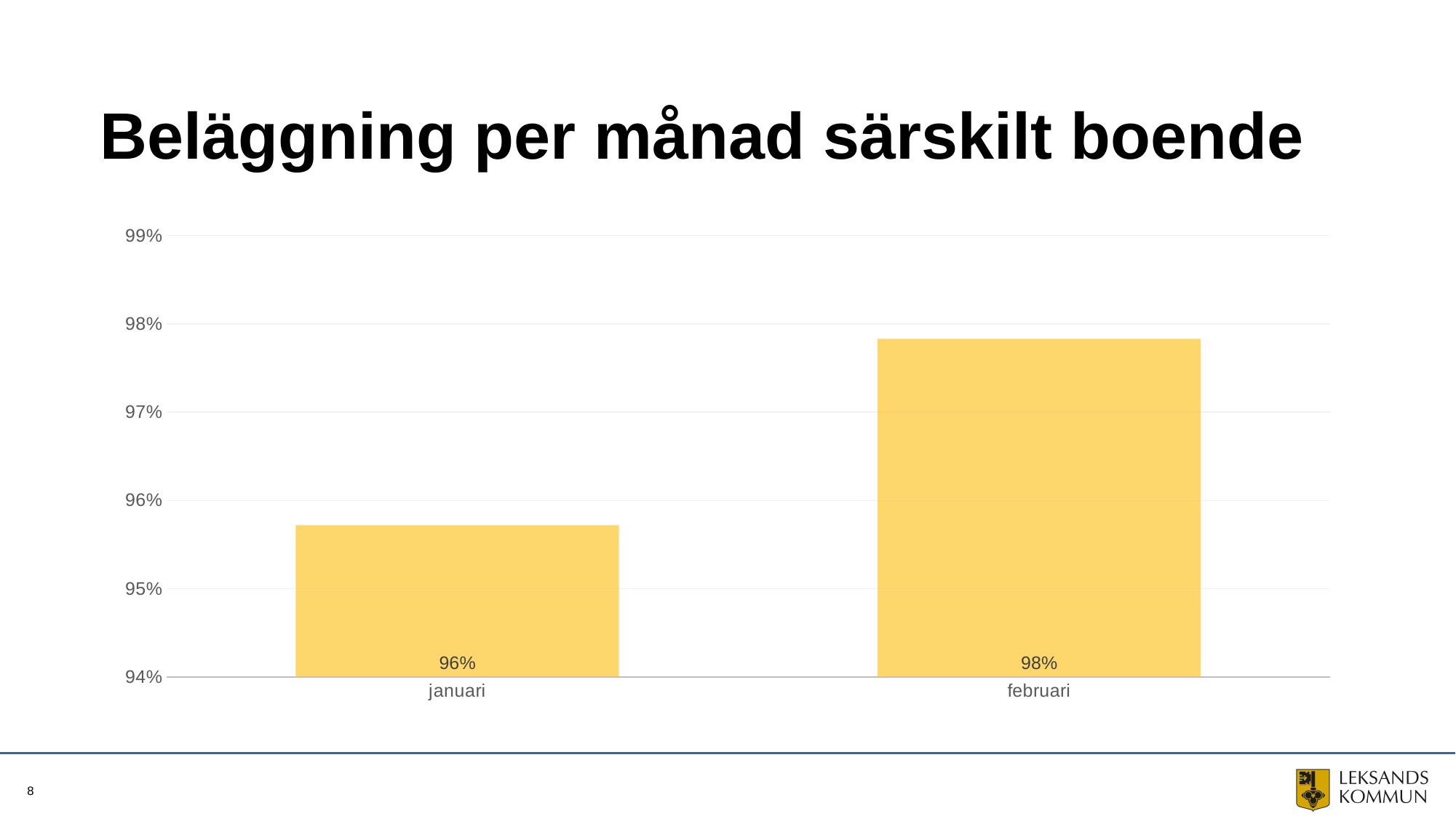
What is the value for januari? 96% What is the difference between the labelled values for februari and januari? 2% Is the value for februari greater or less than 97%? greater Which month has the highest value? februari Which month has the lowest value? januari Which is larger, the value for januari or the value for februari? februari How many months are shown on the chart? 2 What kind of chart is shown on the slide? bar chart Is the value for januari greater or less than 95%? greater What is the value for februari? 98% Do the values rise or fall from januari to februari? rise What is the title of the slide? Beläggning per månad särskilt boende